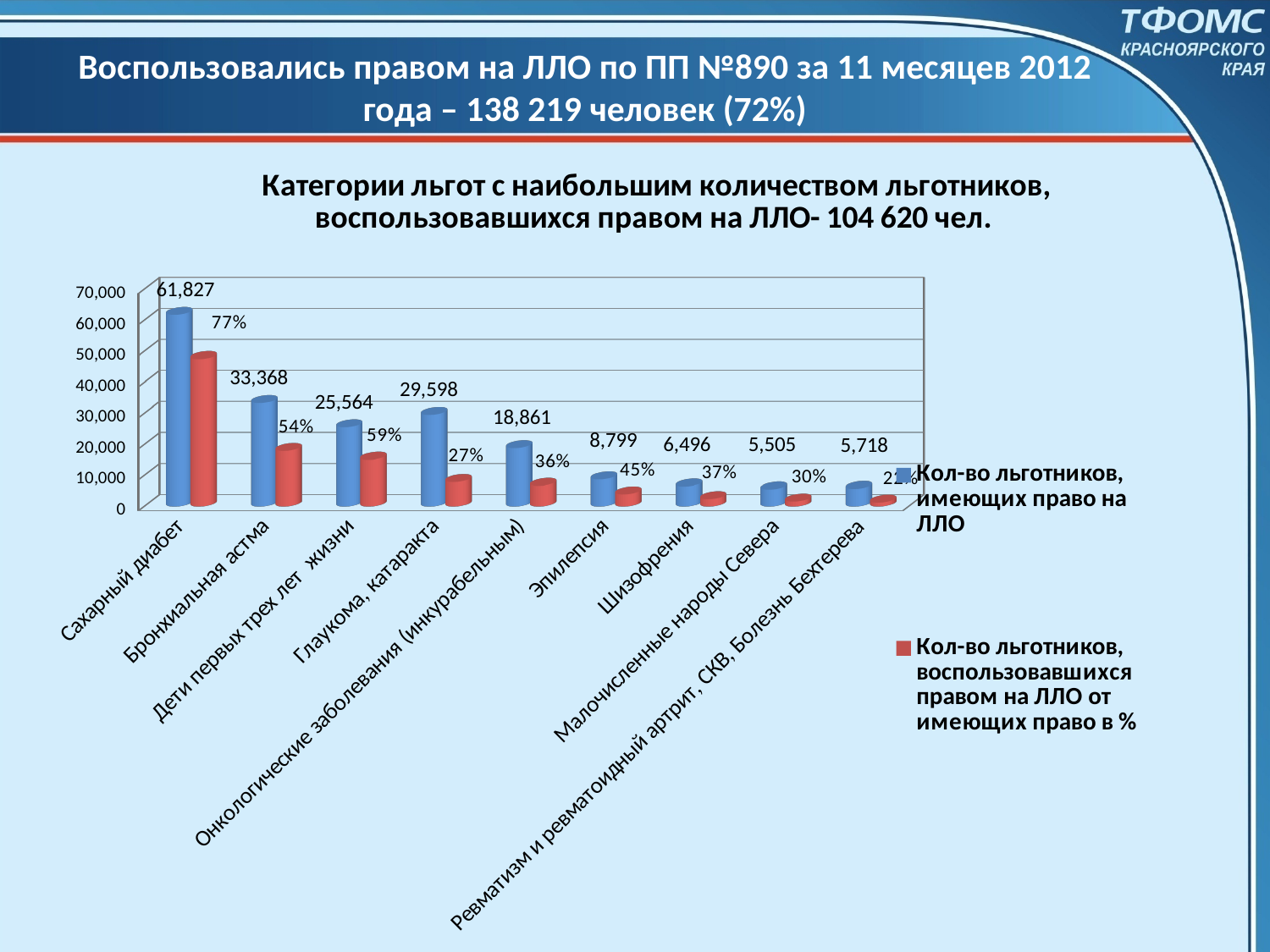
What percentage of entitled beneficiaries used their right to ЛЛО for Бронхиальная астма? 54% What type of chart is shown on the slide? Bar chart What is the difference between the number of entitled beneficiaries for Бронхиальная астма and for Глаукома, катаракта? 3,770 What is the number of beneficiaries entitled to ЛЛО (blue series) for Сахарный диабет? 61,827 Which category has the highest percentage of beneficiaries who used their right to ЛЛО? Сахарный диабет Which has more entitled beneficiaries: Глаукома, катаракта or Дети первых трех лет жизни? Глаукома, катаракта What percentage is shown for Эпилепсия in the red series? 45% How many series does the chart legend list? 2 Which category has the lowest number of beneficiaries entitled to ЛЛО (blue series)? Малочисленные народы Севера Which category has the highest number of beneficiaries entitled to ЛЛО? Сахарный диабет What is the number of entitled beneficiaries shown for Онкологические заболевания (инкурабельным)? 18,861 How many categories are shown on the x axis of the chart? 9